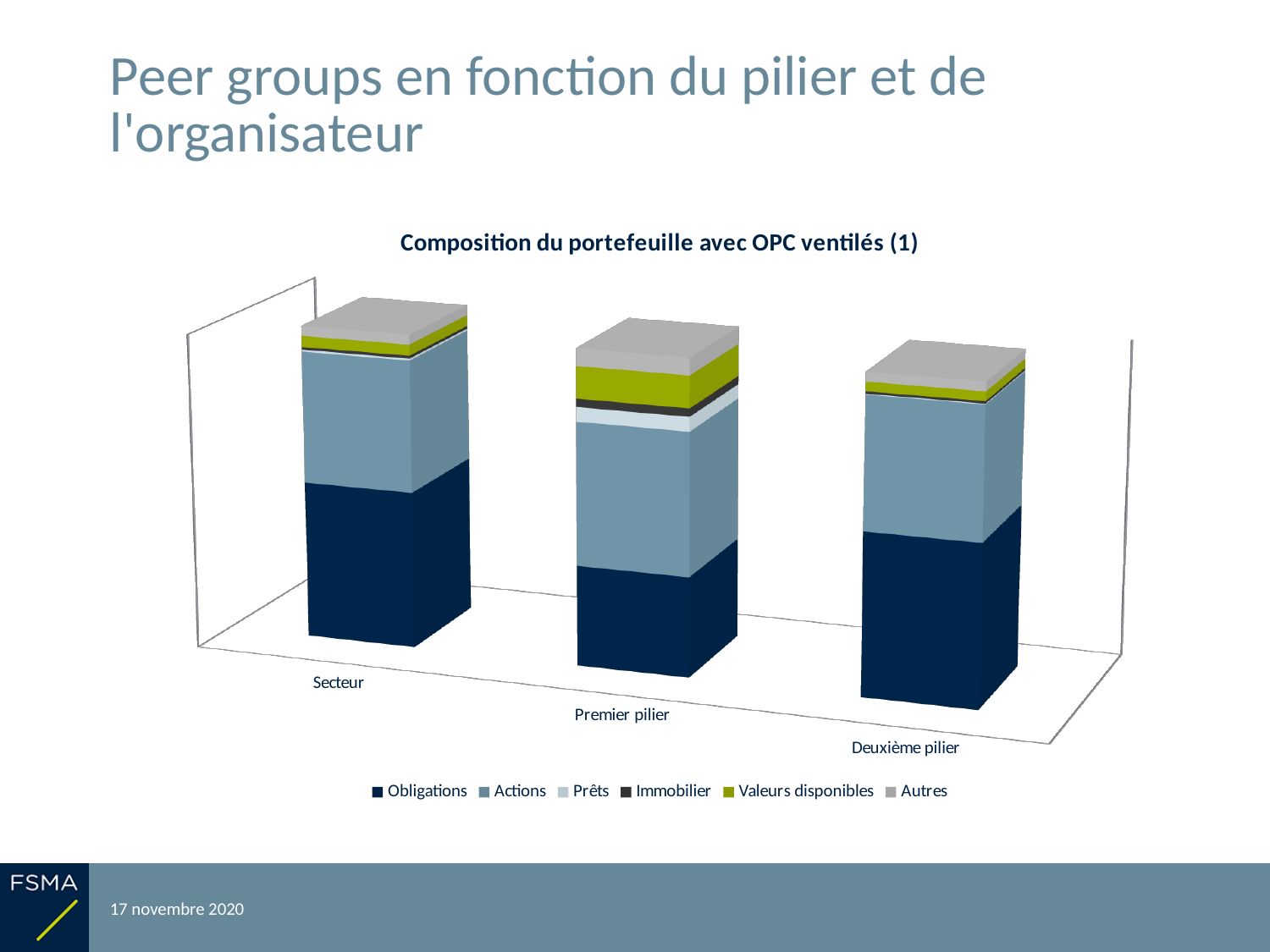
Which category has the largest Immobilier segment? Premier pilier How many categories are shown along the x axis of the chart? 3 In the Premier pilier bar, which segment is larger: Obligations or Actions? Actions Which category has the largest Valeurs disponibles segment? Premier pilier Which category has the smallest Obligations segment? Premier pilier Which category has the largest Prêts segment? Premier pilier How many series does the chart legend list? 6 Which series is shown at the bottom of each stacked bar? Obligations Is the Valeurs disponibles segment larger for Premier pilier or for Deuxième pilier? Premier pilier What kind of chart is shown on the slide? Stacked bar chart What is the title of the chart? Composition du portefeuille avec OPC ventilés (1)